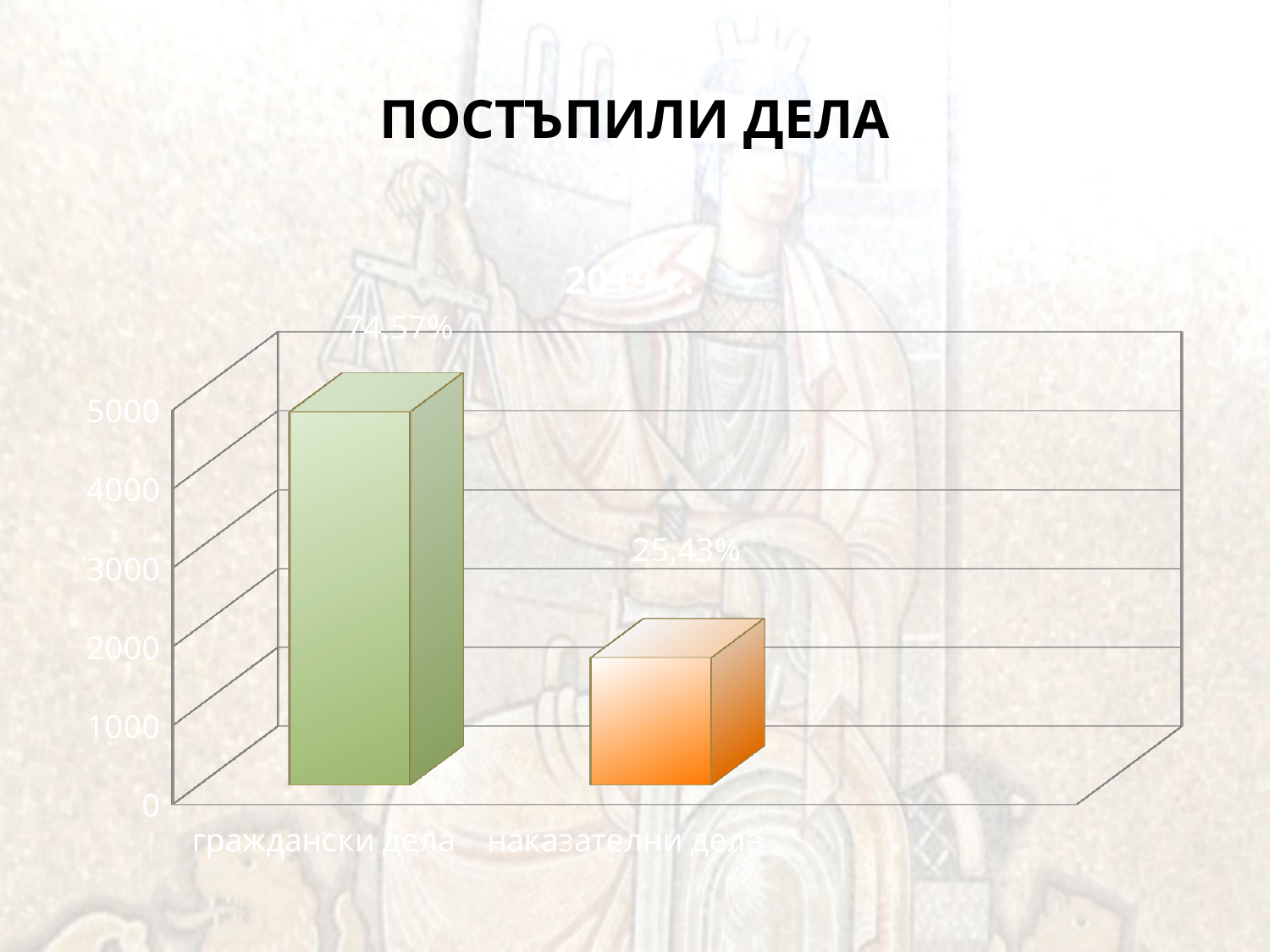
Which category has the highest bar? граждански дела What is the data label shown for граждански дела? 74,57% Which is larger, the bar for граждански дела or the bar for наказателни дела? граждански дела Is the value for наказателни дела greater or less than 3000? less Which category has the lowest bar? наказателни дела Is the value for граждански дела greater or less than 3000? greater What is the title of the slide? ПОСТЪПИЛИ ДЕЛА What is the difference between the percentage labels for граждански дела and наказателни дела? 49,14% How many categories are shown on the x axis of the chart? 2 What colour is the bar for наказателни дела? orange What is the data label shown for наказателни дела? 25,43% What kind of chart is shown on the slide? bar chart